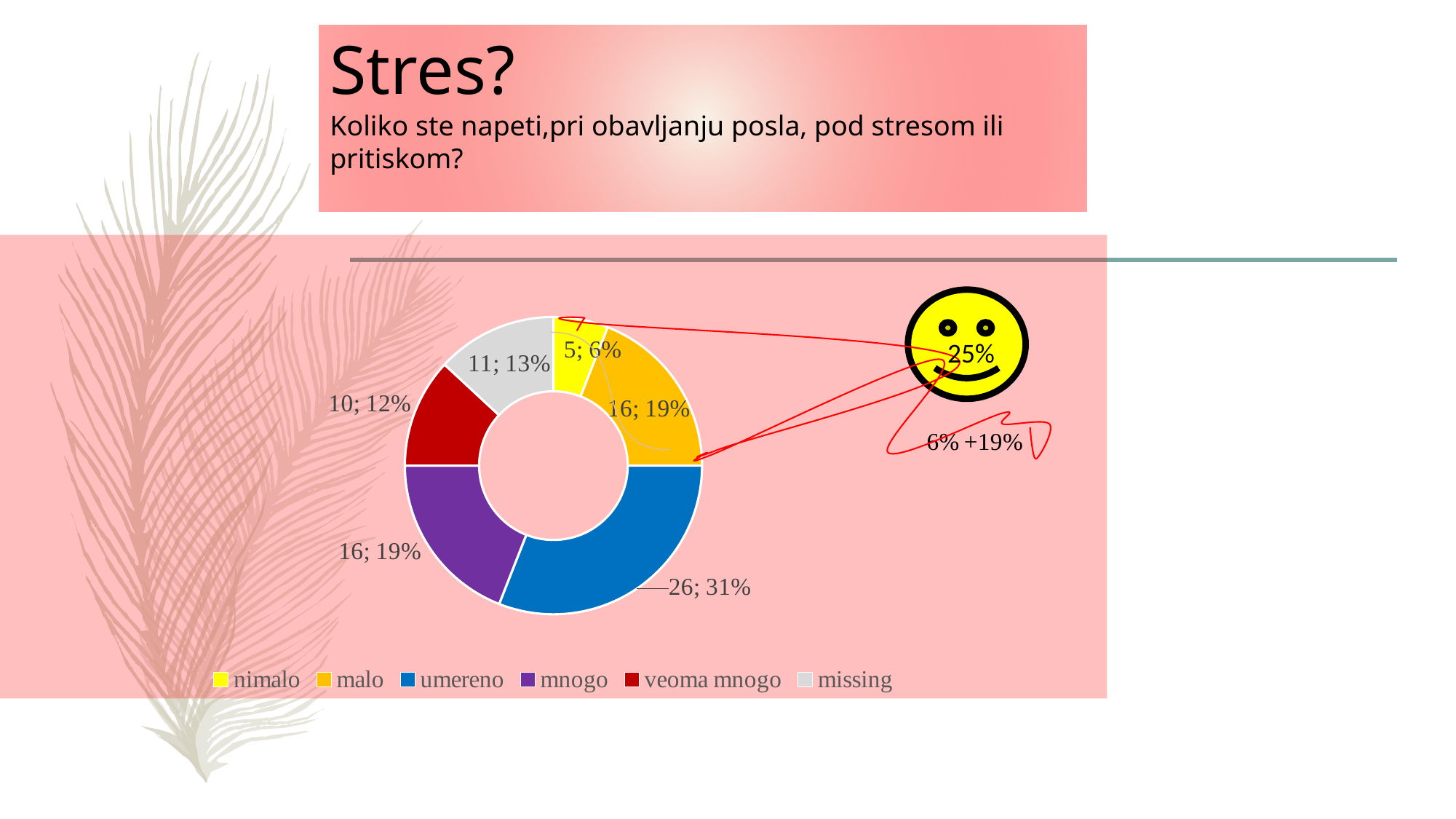
What is the combined percentage of the 'nimalo' and 'malo' slices? 25% What colour is the 'umereno' slice in the chart? blue What is the count shown for the 'umereno' slice? 26 Which slice is larger, 'veoma mnogo' or 'missing'? missing What percentage share is shown for the 'nimalo' slice? 6% What kind of chart is shown on the slide? doughnut chart What is the count shown for the 'veoma mnogo' slice? 10 What is the difference between the counts for 'umereno' and 'mnogo'? 10 Which category has the largest slice in the chart? umereno What percentage share is shown for the 'missing' slice? 13% Which category has the smallest slice in the chart? nimalo How many categories does the legend of the chart list? 6